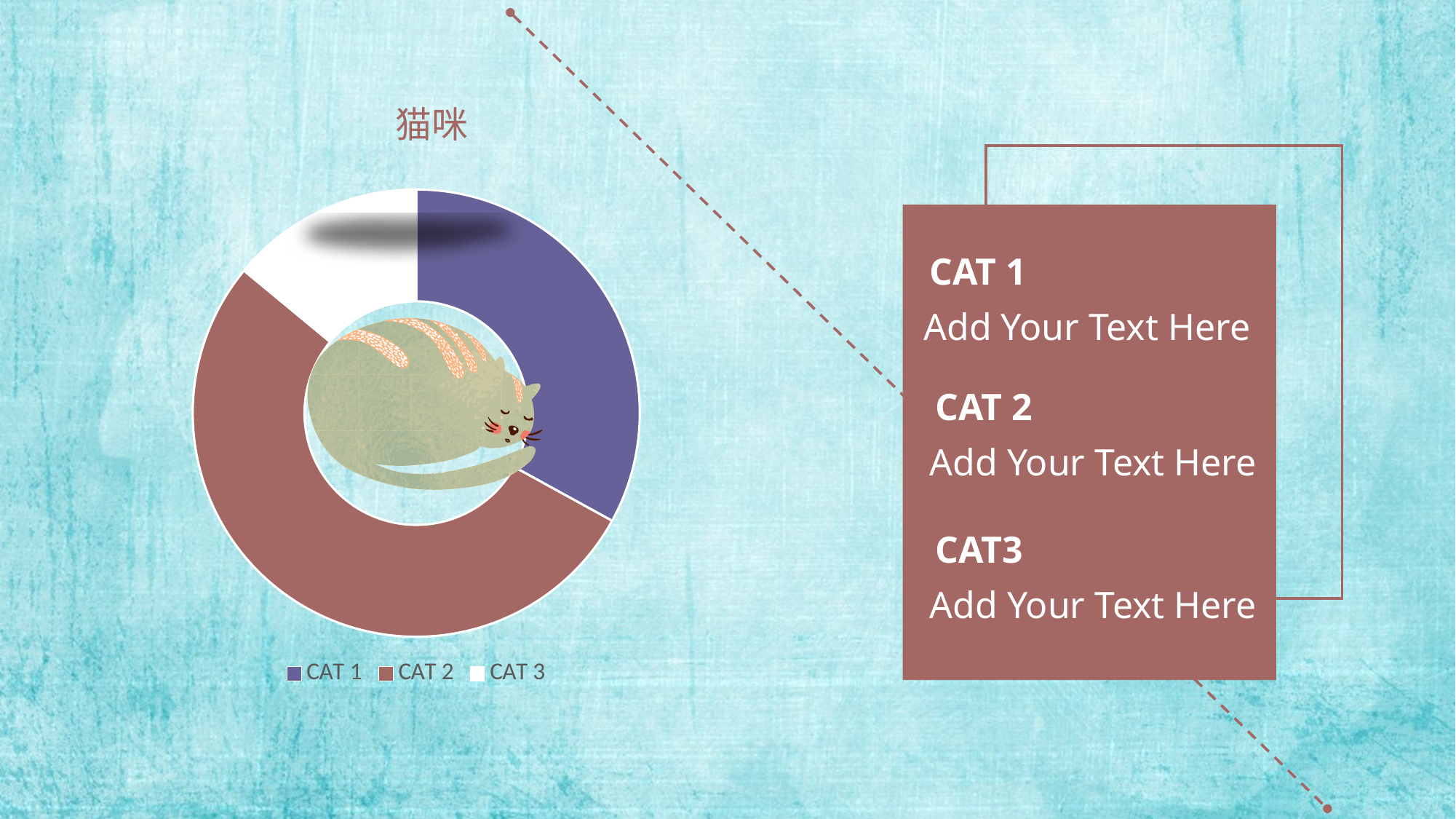
How many entries does the chart legend list? 3 What is the title of the chart? 猫咪 Which slice is larger, CAT 1 or CAT 3? CAT 1 How many categories does the chart show? 3 What kind of chart is shown on the slide? Doughnut (pie) chart Which category is shown in white in the chart? CAT 3 Which slice is larger, CAT 1 or CAT 2? CAT 2 What colour is the CAT 1 slice in the chart? Purple Which category has the largest slice of the chart? CAT 2 Which slice is smaller, CAT 2 or CAT 3? CAT 3 Which category has the smallest slice of the chart? CAT 3